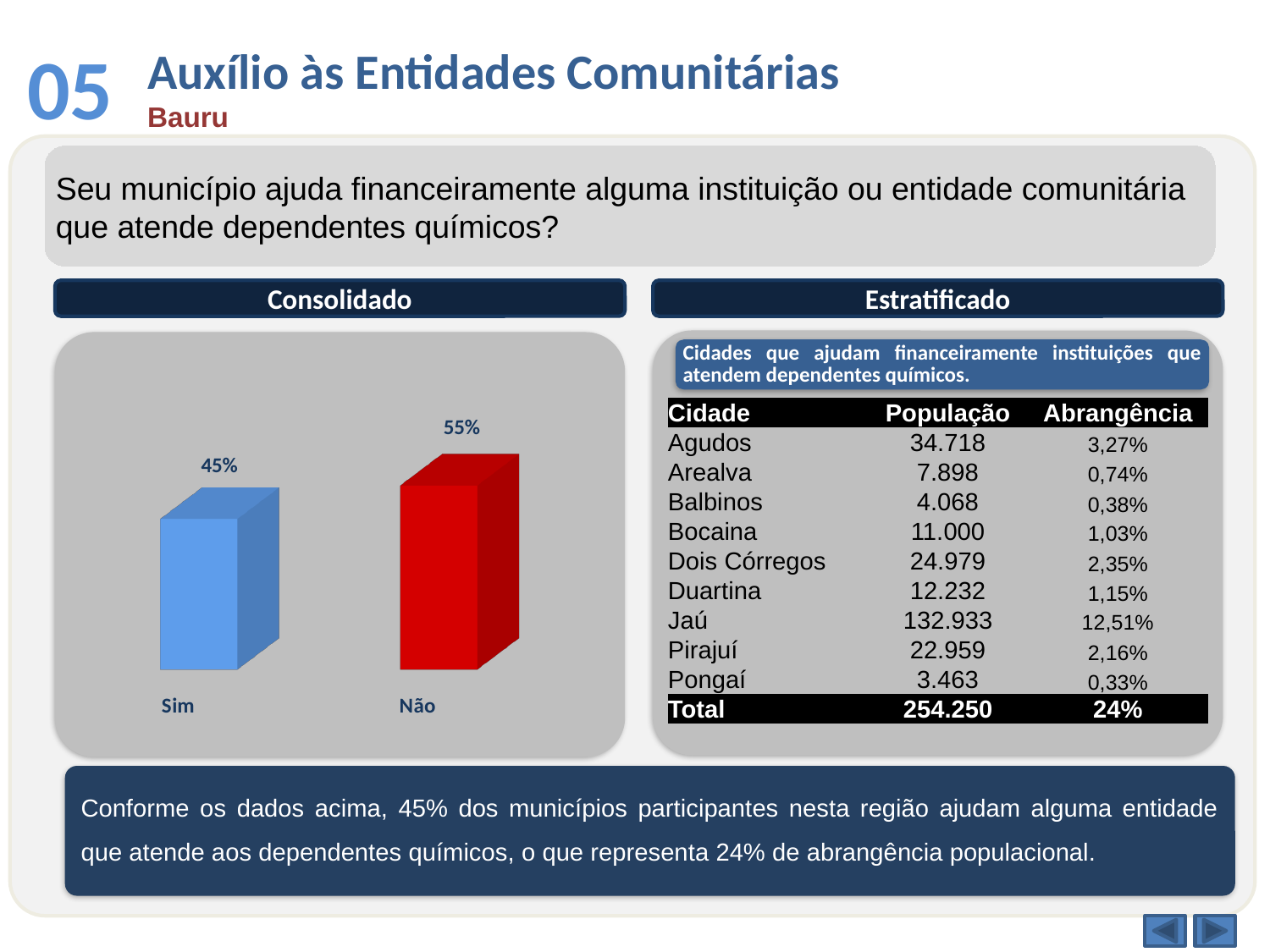
What kind of chart is shown under the Consolidado heading? bar chart In the Consolidado chart, which is larger, the value for Sim or the value for Não? Não In the Consolidado chart, what is the difference between the values for Não and Sim? 10% In the Consolidado chart, what colour is the bar for Sim? blue In the Consolidado chart, what is the value for Sim? 45% In the Consolidado chart, which category has the lowest value? Sim In the Consolidado chart, what colour is the bar for Não? red In the Consolidado chart, which category has the highest value? Não How many categories are shown in the Consolidado chart? 2 In the Consolidado chart, what is the value for Não? 55%